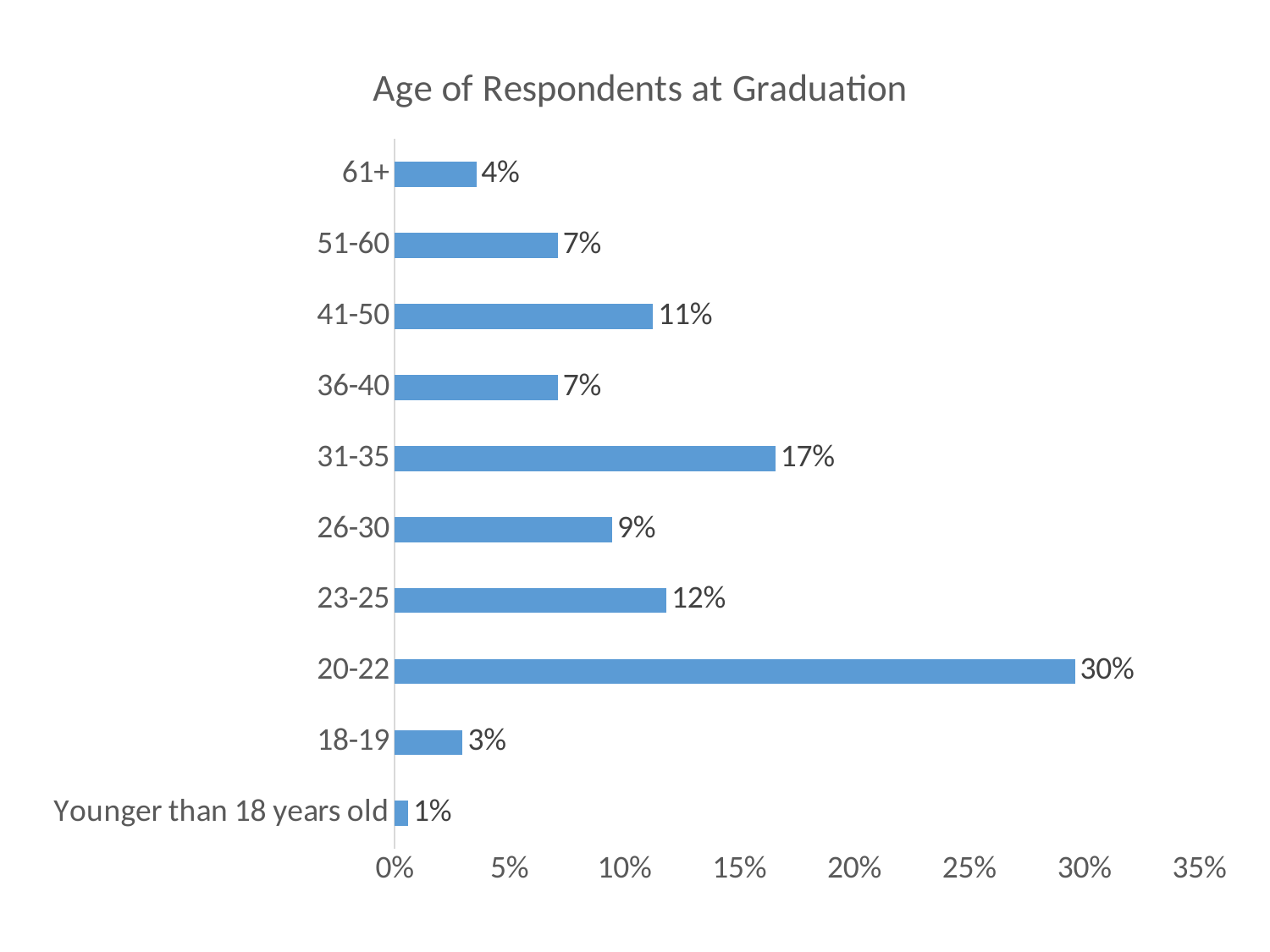
What percentage of respondents were aged 20-22 at graduation? 30% Which is larger, the value for 41-50 or the value for 26-30? 41-50 What is the highest value shown on the horizontal axis? 35% What kind of chart is this? Bar chart How many age categories are shown in the chart? 10 What is the title of the chart? Age of Respondents at Graduation What percentage of respondents were younger than 18 years old at graduation? 1% What is the value for the 31-35 age group? 17% What is the difference between the 20-22 and 23-25 age groups? 18% Which age group has the highest percentage of respondents? 20-22 Is the value for 31-35 greater or less than 15%? greater Which age group has the lowest percentage of respondents? Younger than 18 years old